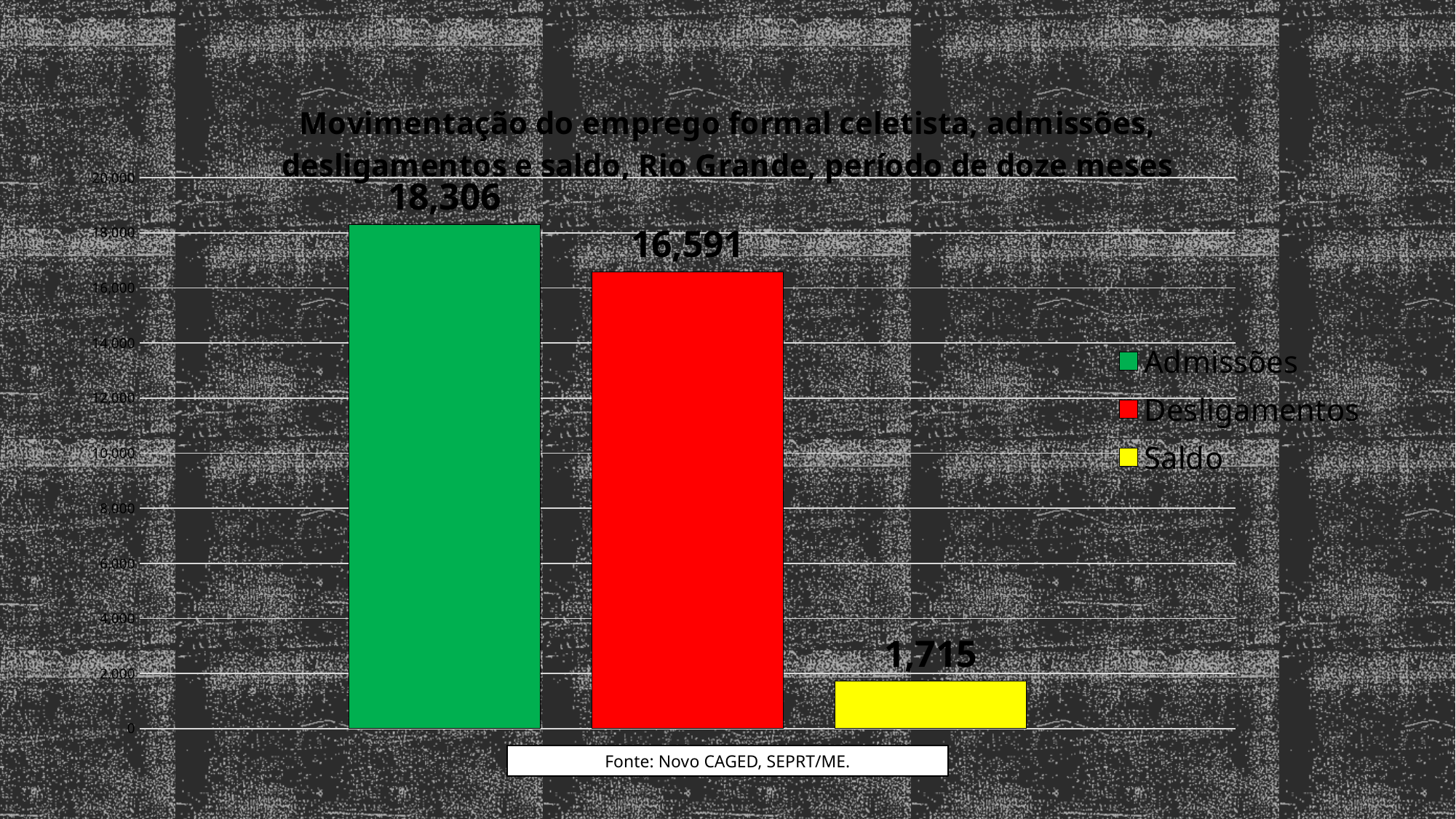
Which series has the lowest value? Saldo What is the value for Saldo? 1,715 What is the difference between Admissões and Desligamentos? 1,715 What source is cited below the chart? Fonte: Novo CAGED, SEPRT/ME. Is the value for Desligamentos greater or less than 16,000? greater What is the value for Admissões? 18,306 What kind of chart is shown on the slide? bar chart How many series does the legend list? 3 Which series has the highest value? Admissões What colour is the bar for Saldo? yellow What is the value for Desligamentos? 16,591 Which is larger, Desligamentos or Saldo? Desligamentos